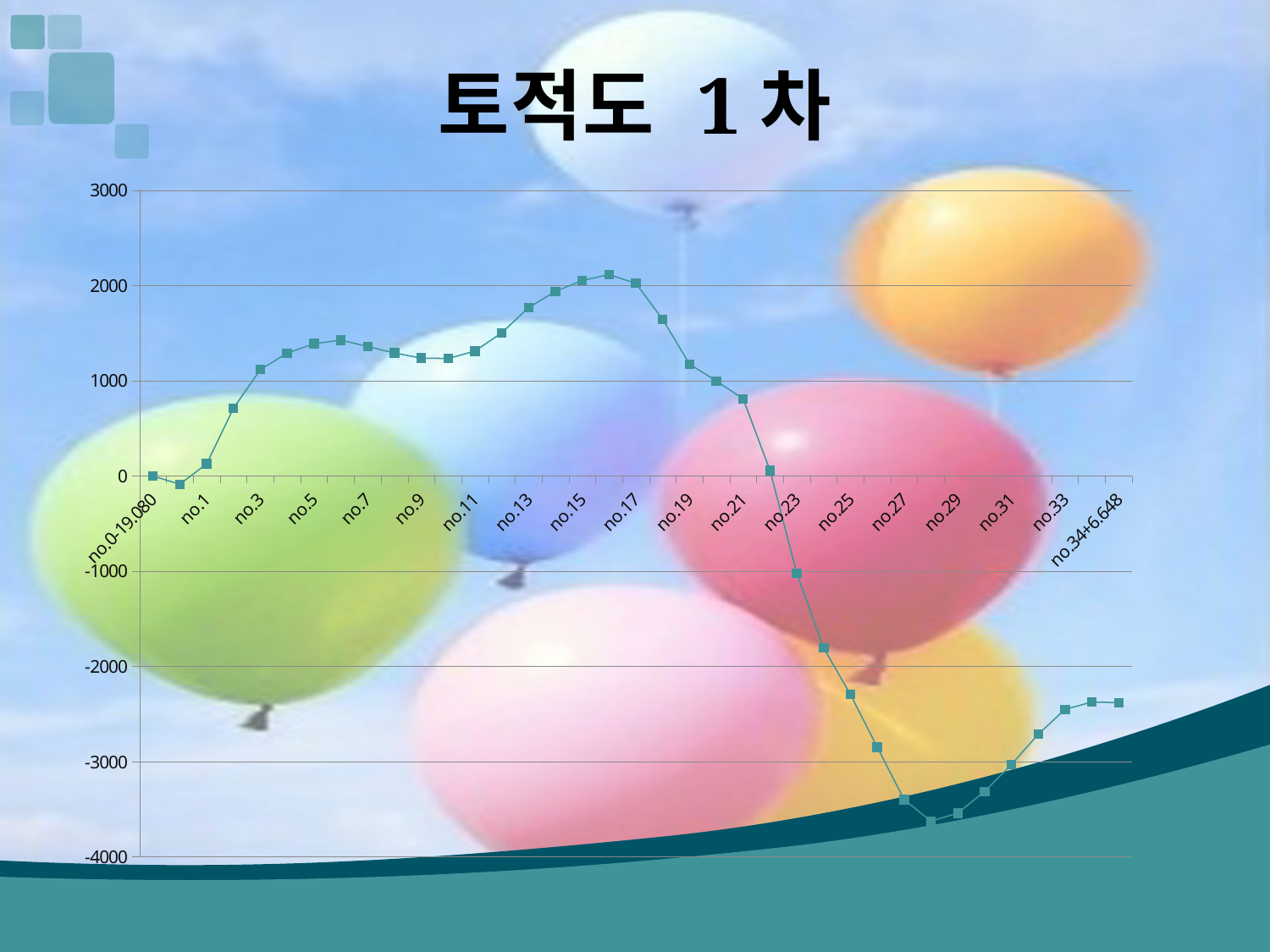
What is the title of the chart? 토적도 1 차 How many category labels are shown along the x axis? 19 Which has the larger value, no.3 or no.13? no.13 Which has the larger value, no.23 or no.27? no.23 Do the values rise or fall from no.17 to no.27? fall Is the value for no.21 greater or less than 1000? less Is the value for no.13 greater or less than 1500? greater Is the value for no.25 greater or less than -2000? less What kind of chart is shown on the slide? line chart Do the values rise or fall from no.29 to no.33? rise